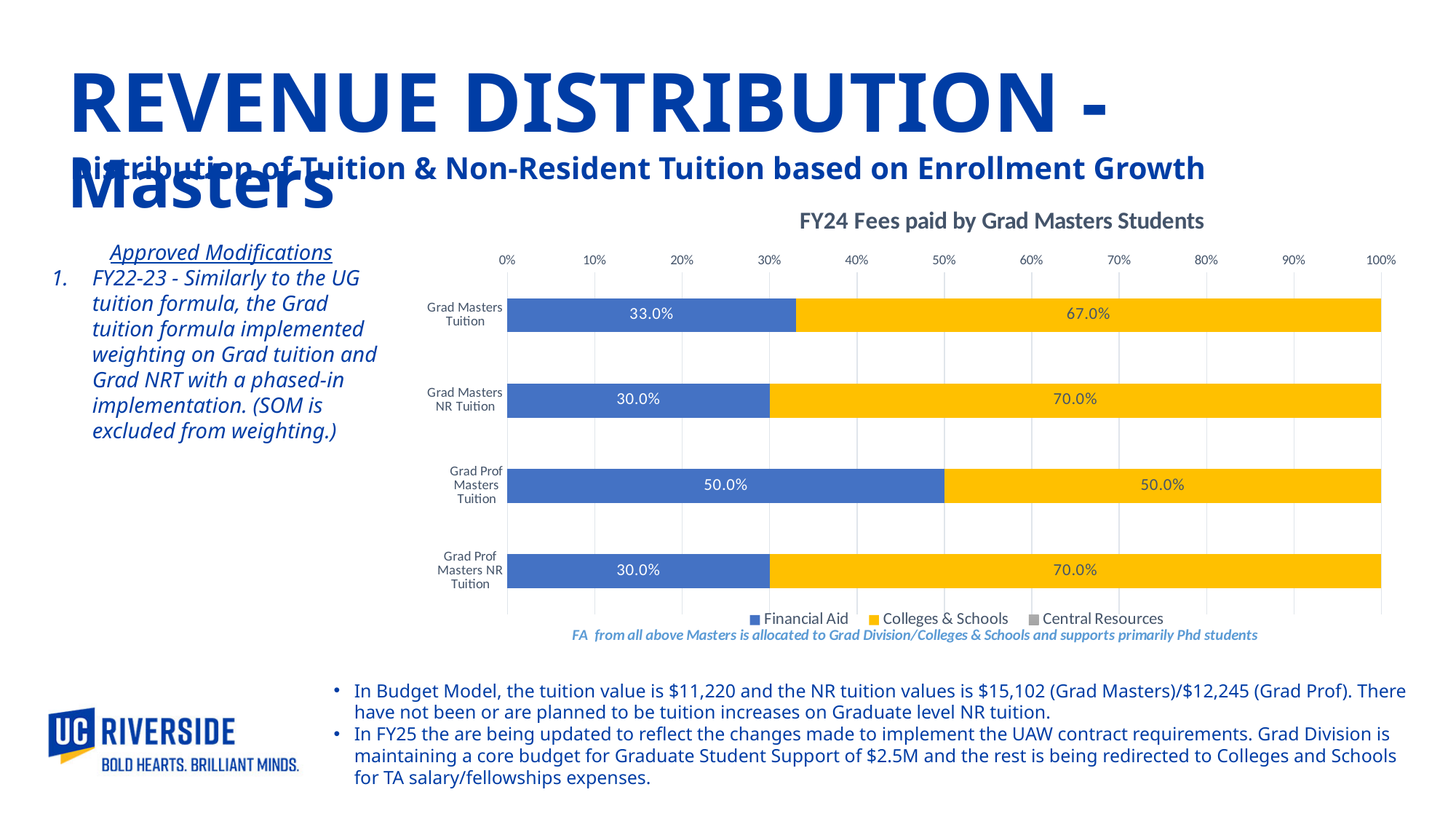
What is the Colleges & Schools share for Grad Masters NR Tuition? 70.0% What is the difference between the Colleges & Schools share and the Financial Aid share for Grad Masters Tuition? 34.0% What is the Financial Aid share for Grad Prof Masters Tuition? 50.0% What is the Financial Aid share for Grad Masters Tuition? 33.0% What is the title of the chart? FY24 Fees paid by Grad Masters Students Which category has the highest Financial Aid share? Grad Prof Masters Tuition How many categories are shown on the chart? 4 Which is larger for Grad Masters NR Tuition: the Financial Aid share or the Colleges & Schools share? Colleges & Schools What kind of chart is shown on the slide? Stacked bar chart How many series does the legend list? 3 Which category has the lowest Colleges & Schools share? Grad Prof Masters Tuition What is the Colleges & Schools share for Grad Prof Masters NR Tuition? 70.0%